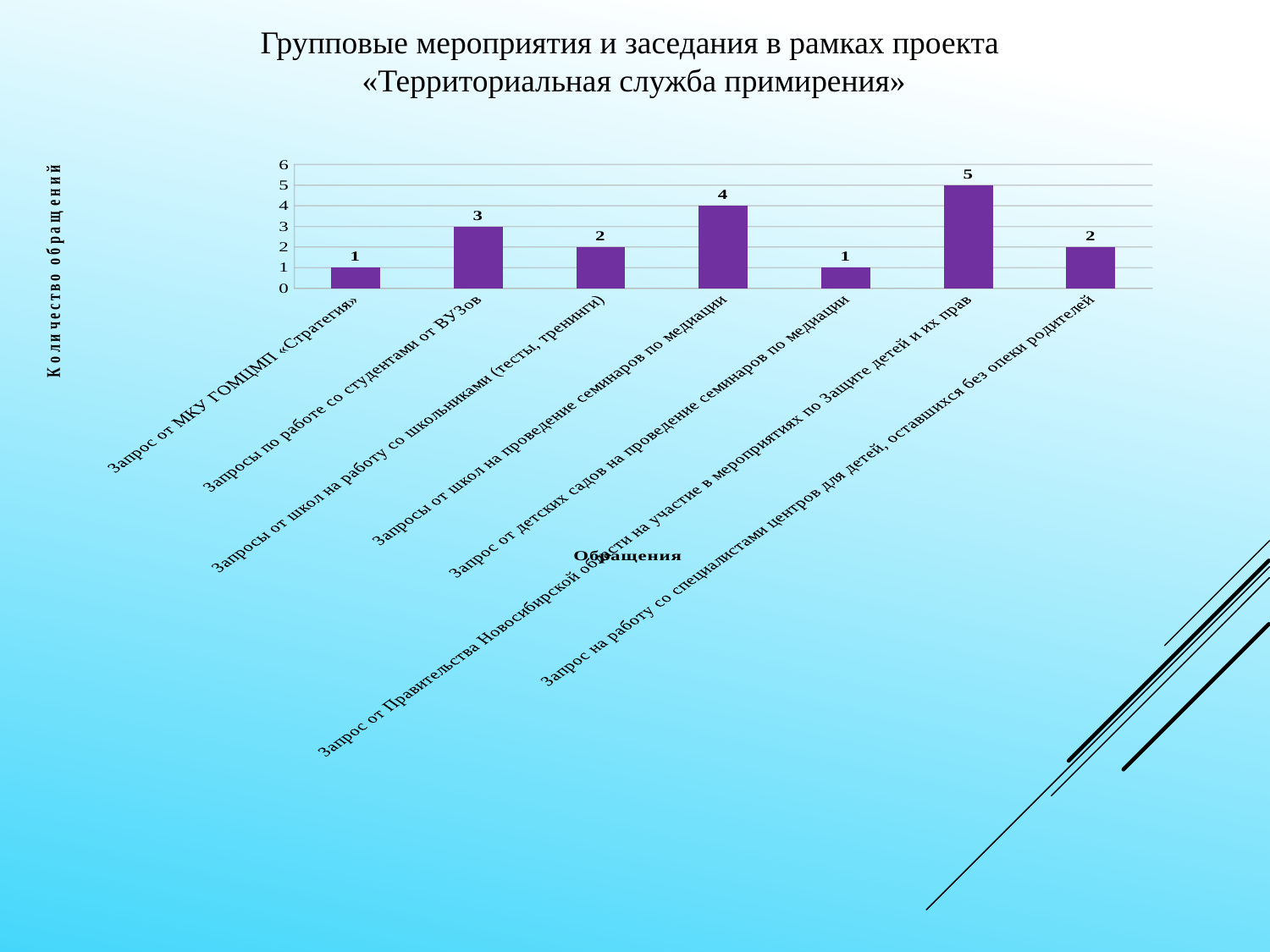
What is the title of the vertical axis? Количество обращений What is the title of the horizontal axis? Обращения How many categories are plotted in the chart? 7 What type of chart is shown on the slide? bar chart What is the difference between the value for «Запросы по работе со студентами от ВУЗов» and the value for «Запросы от школ на работу со школьниками (тесты, тренинги)»? 1 What is the value for «Запрос на работу со специалистами центров для детей, оставшихся без опеки родителей»? 2 Which is larger: the value for «Запросы от школ на проведение семинаров по медиации» or the value for «Запросы по работе со студентами от ВУЗов»? Запросы от школ на проведение семинаров по медиации What is the value for «Запрос от детских садов на проведение семинаров по медиации»? 1 What is the difference between the value for «Запрос от Правительства Новосибирской области на участие в мероприятиях по Защите детей и их прав» and the value for «Запрос от МКУ ГОМЦМП «Стратегия»»? 4 What is the value for «Запросы от школ на проведение семинаров по медиации»? 4 Which category has the highest value? Запрос от Правительства Новосибирской области на участие в мероприятиях по Защите детей и их прав What is the value for «Запросы по работе со студентами от ВУЗов»? 3